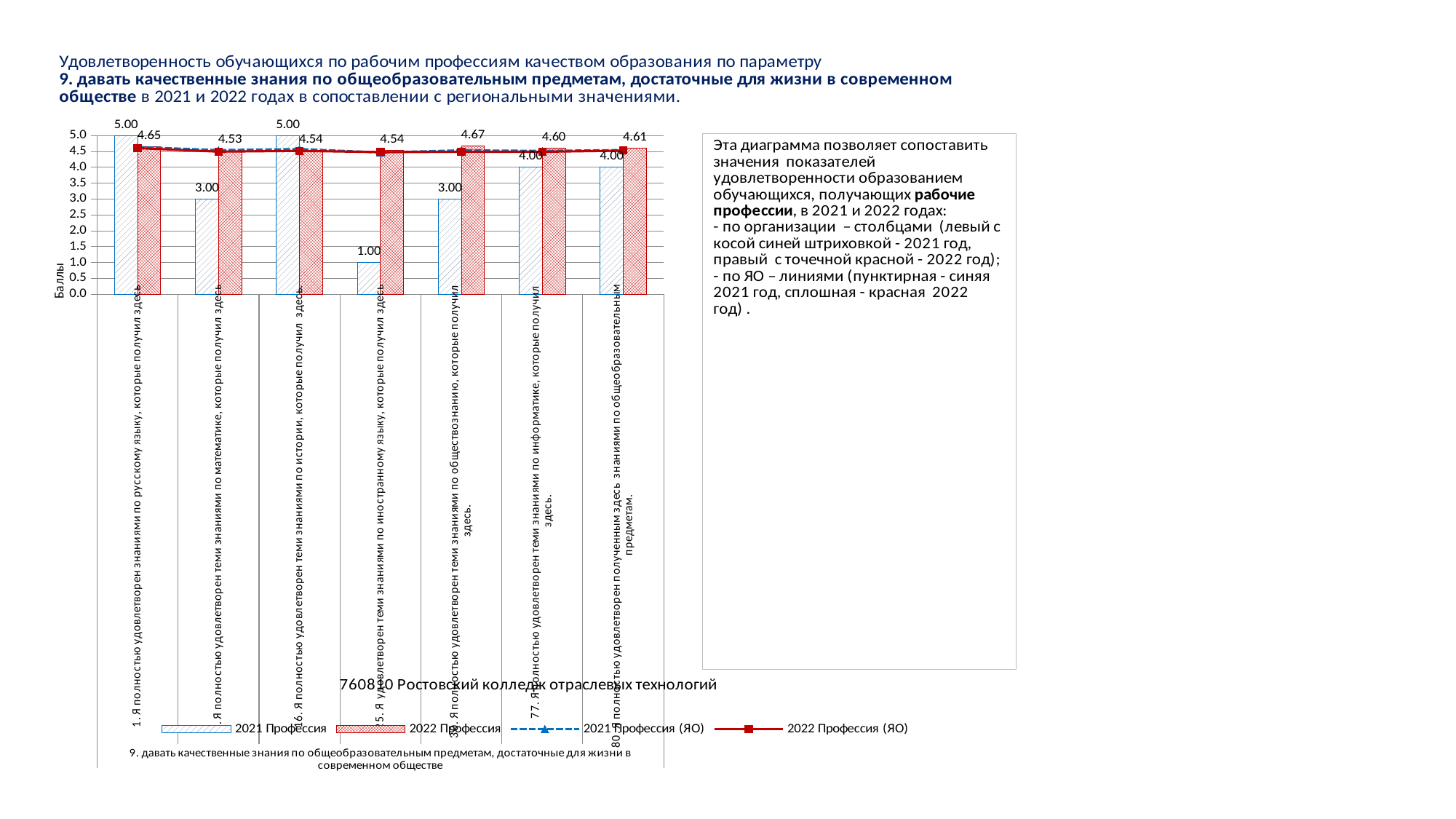
What is the 2021 Профессия value for the category about знания по иностранному языку? 1.00 Is the 2022 Профессия bar for the category about иностранный язык greater or less than 4.0? greater What kind of chart is this? bar chart combined with line series Which is larger, the 2021 Профессия value for история or for обществознание? история What is the 2021 Профессия value for the category about знания по русскому языку? 5.00 What is the difference between the 2021 Профессия values for русский язык and математика? 2.00 What is the title of the vertical axis? Баллы Which category has the lowest 2021 Профессия value? Я удовлетворен теми знаниями по иностранному языку, которые получил здесь What is the 2021 Профессия value for the category about знания по информатике? 4.00 How many categories are shown on the x axis? 7 How many series does the legend list? 4 What is the 2021 Профессия value for the category about знания по математике? 3.00